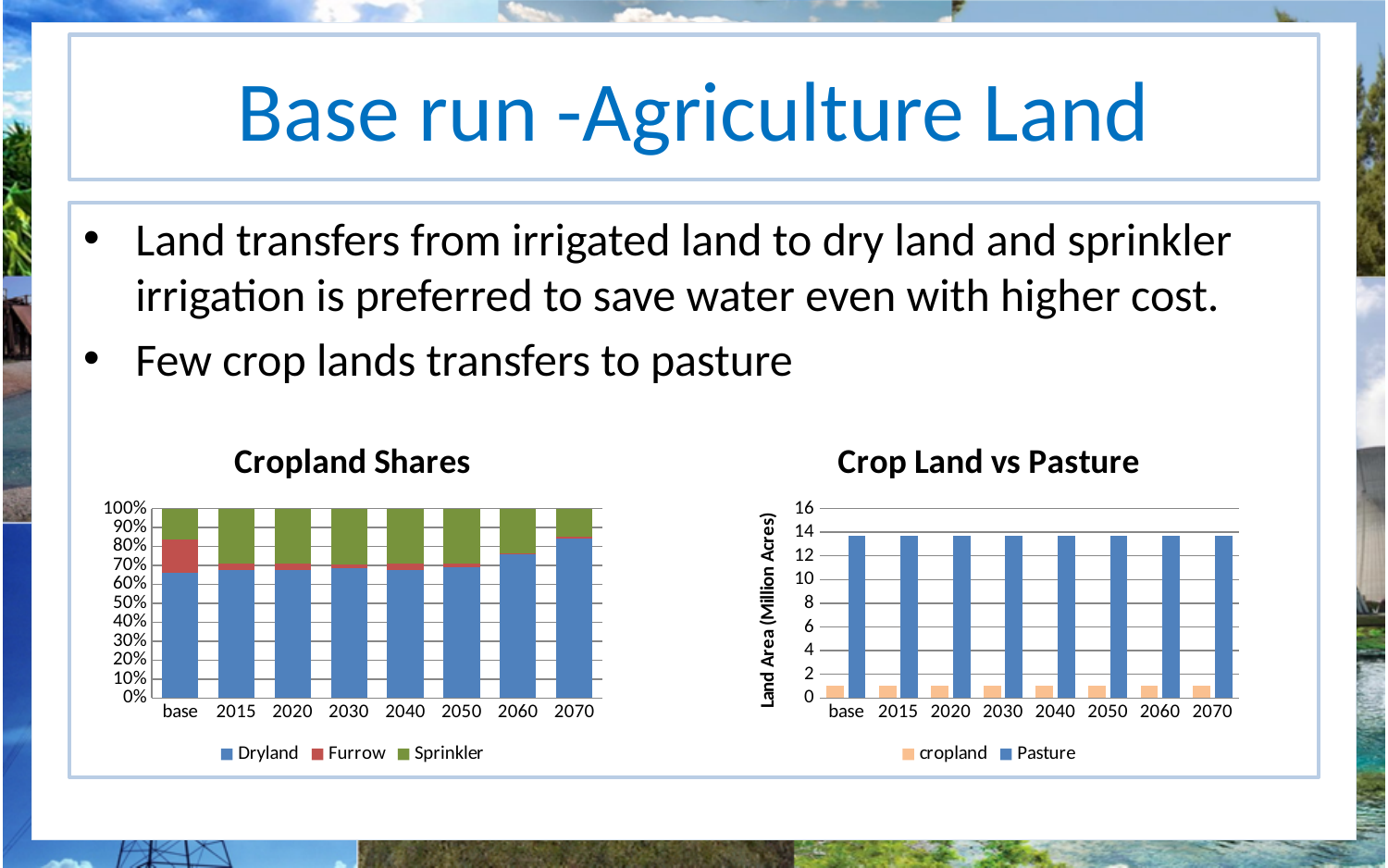
In the Cropland Shares chart, which category has the largest Furrow share? base What kind of chart is the Cropland Shares chart? stacked bar chart How many series does the legend of the Crop Land vs Pasture chart list? 2 In the Cropland Shares chart, which category has the largest Dryland share? 2070 In the Crop Land vs Pasture chart, is the cropland value for base greater or less than 2? less In the Cropland Shares chart, is the Dryland share for 2070 greater or less than 80%? greater In the Crop Land vs Pasture chart, which series has the larger value in 2030, cropland or Pasture? Pasture In the Cropland Shares chart, does the Dryland share rise or fall from base to 2070? rise How many series does the legend of the Cropland Shares chart list? 3 In the Cropland Shares chart, is the Furrow share for 2070 greater or less than 10%? less How many categories are shown on the x axis of the Crop Land vs Pasture chart? 8